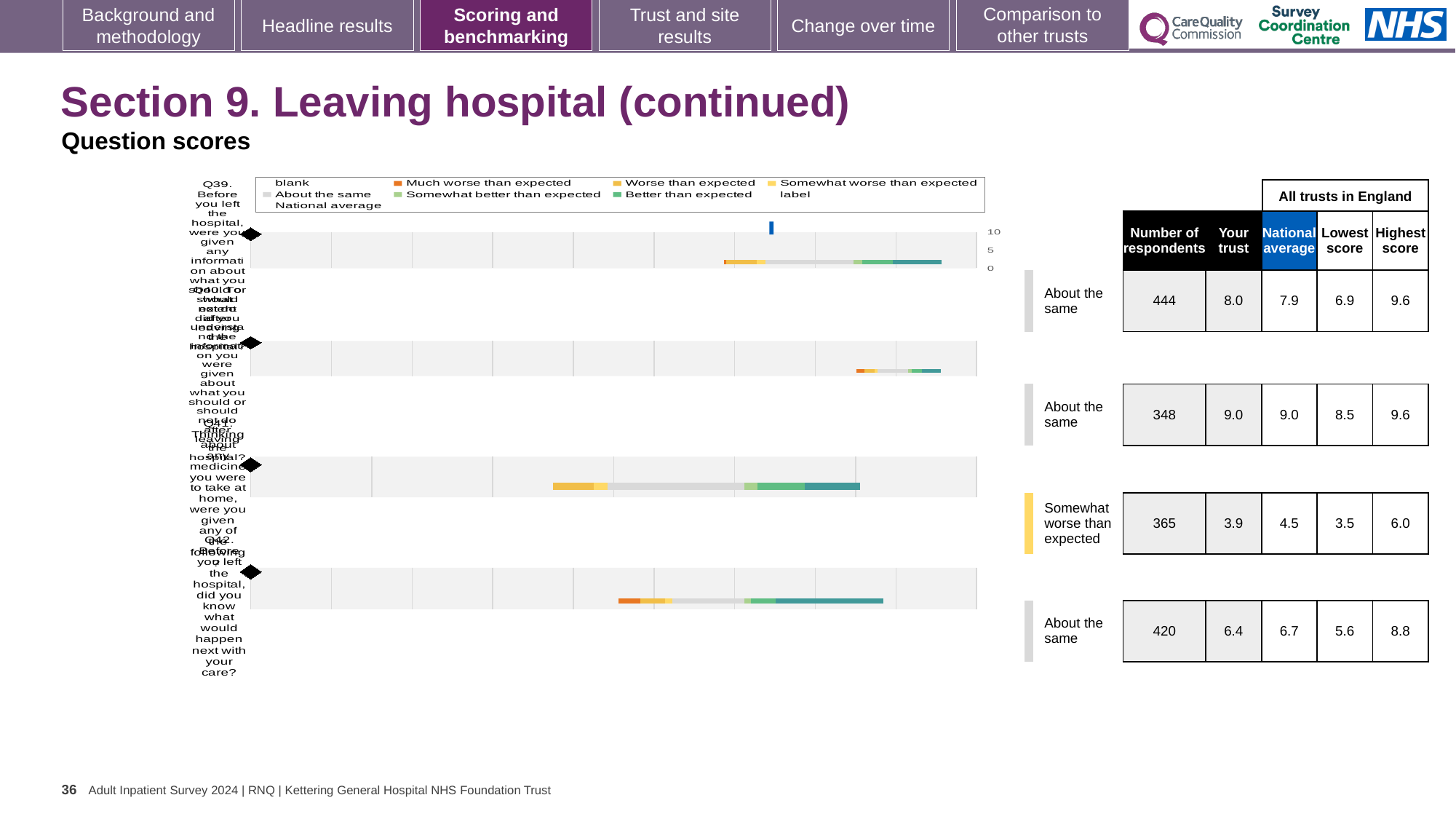
Which question has the lowest 'Your trust' score on this slide? Q41 For Q42, which is larger: the 'Your trust' score or the national average? National average For Q39, what is the difference between the highest score and the lowest score among all trusts in England? 2.7 In the table beside the Q39 chart, what is the 'Your trust' score? 8.0 In the table beside the Q40 chart, how many respondents are listed? 348 Which question has the highest 'Your trust' score on this slide? Q40 What is the maximum value shown on the score axis of the charts? 10 In the table beside the Q41 chart, what is the national average score? 4.5 What kind of chart is used to show the question scores on this slide? bar chart What benchmark category is shown next to the Q41 chart? Somewhat worse than expected How many questions (Q39 to Q42) have a chart on this slide? 4 In the table beside the Q42 chart, what is the highest score among all trusts in England? 8.8